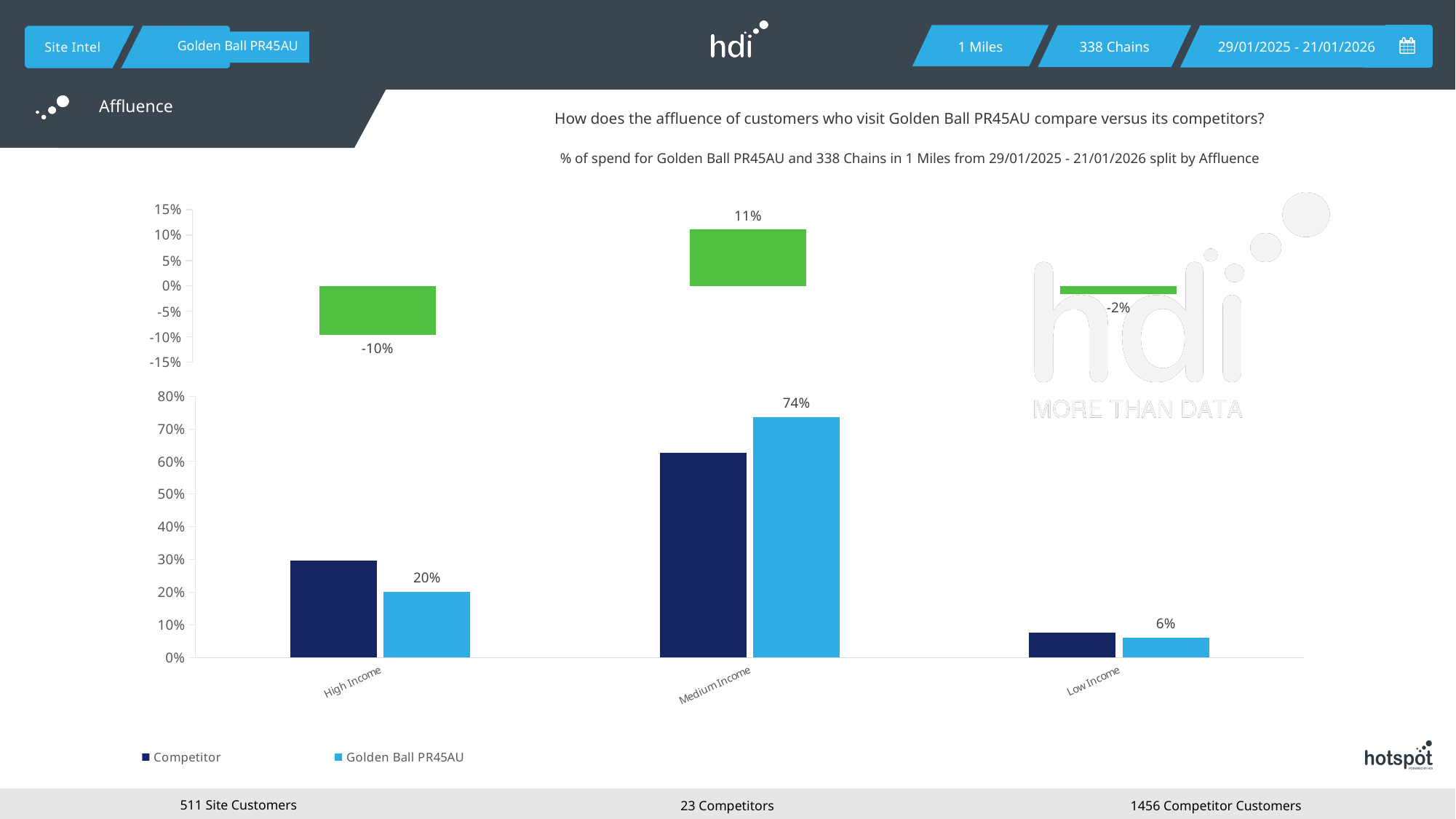
In the bottom chart, is the Competitor value for High Income greater or less than 20%? greater In the bottom chart, what is the difference between the Golden Ball PR45AU values for Medium Income and High Income? 54% In the bottom chart, what is the value for Golden Ball PR45AU in the Low Income category? 6% How many series does the legend of the bottom chart list? 2 In the bottom chart, which category has the highest value for Golden Ball PR45AU? Medium Income In the bottom chart, is the Competitor value for Medium Income greater or less than 70%? less In the bottom chart, what is the value for Golden Ball PR45AU in the Medium Income category? 74% In the top chart, what is the value shown for the Low Income category? -2% In the bottom chart, what is the value for Golden Ball PR45AU in the High Income category? 20% In the top chart, what is the value shown for the Medium Income category? 11% In the bottom chart, which category has the lowest value for Golden Ball PR45AU? Low Income In the top chart, what is the value shown for the High Income category? -10%